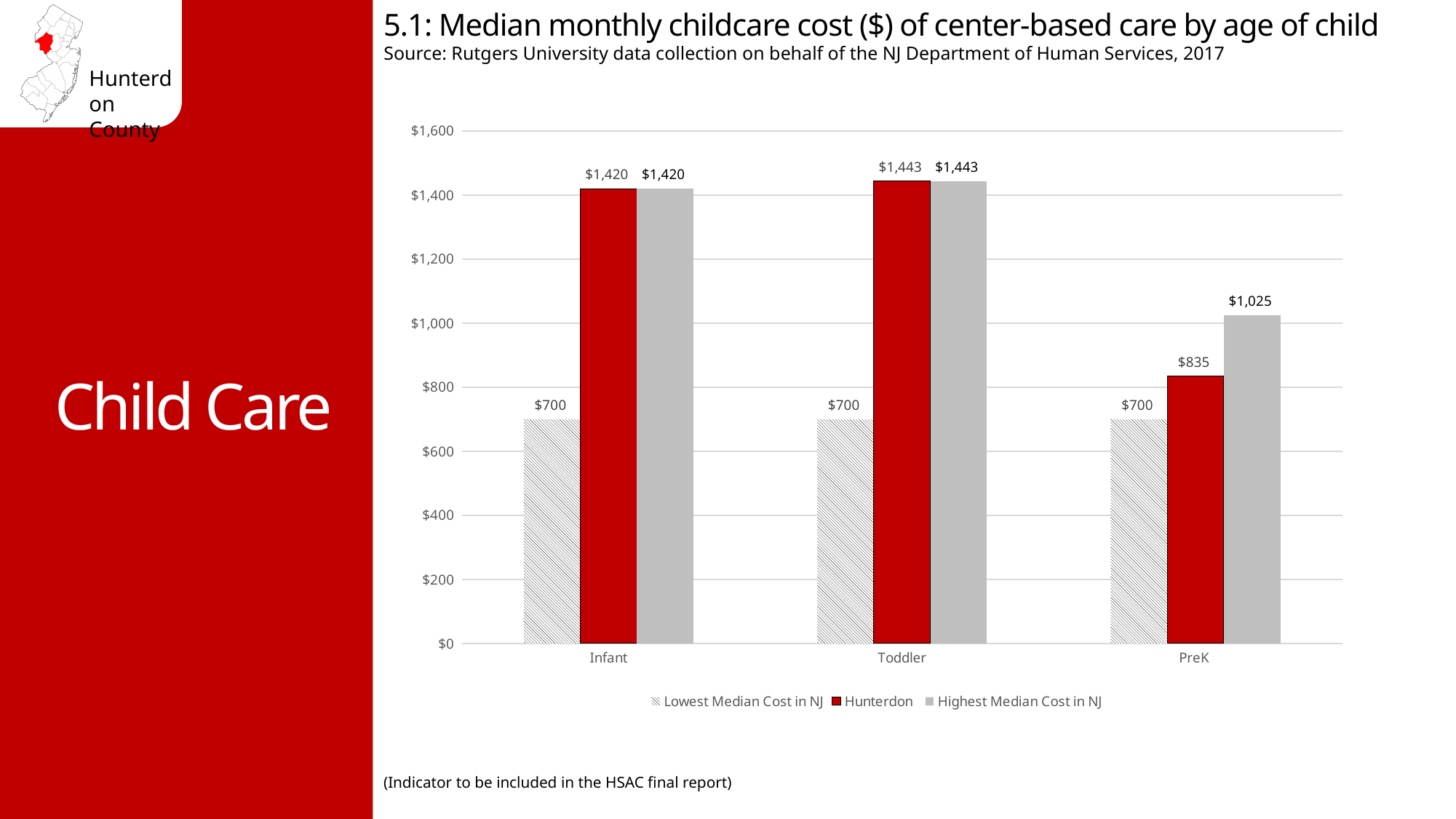
How many series does the legend list? 3 What is the Highest Median Cost in NJ for PreK care? $1,025 What is the difference between the Highest Median Cost in NJ and the Hunterdon value for PreK? $190 What is the Hunterdon value for Toddler care? $1,443 Which is larger for PreK: the Hunterdon value or the Lowest Median Cost in NJ? Hunterdon How many age groups are shown on the x axis? 3 What is the difference between the Hunterdon value for Infant care and the Lowest Median Cost in NJ for Infant care? $720 Which age group has the highest Hunterdon median monthly cost? Toddler What is the Hunterdon median monthly childcare cost for Infant care? $1,420 What is the Lowest Median Cost in NJ for Toddler care? $700 Which age group has the lowest Hunterdon median monthly cost? PreK What kind of chart is shown on the slide? Bar chart